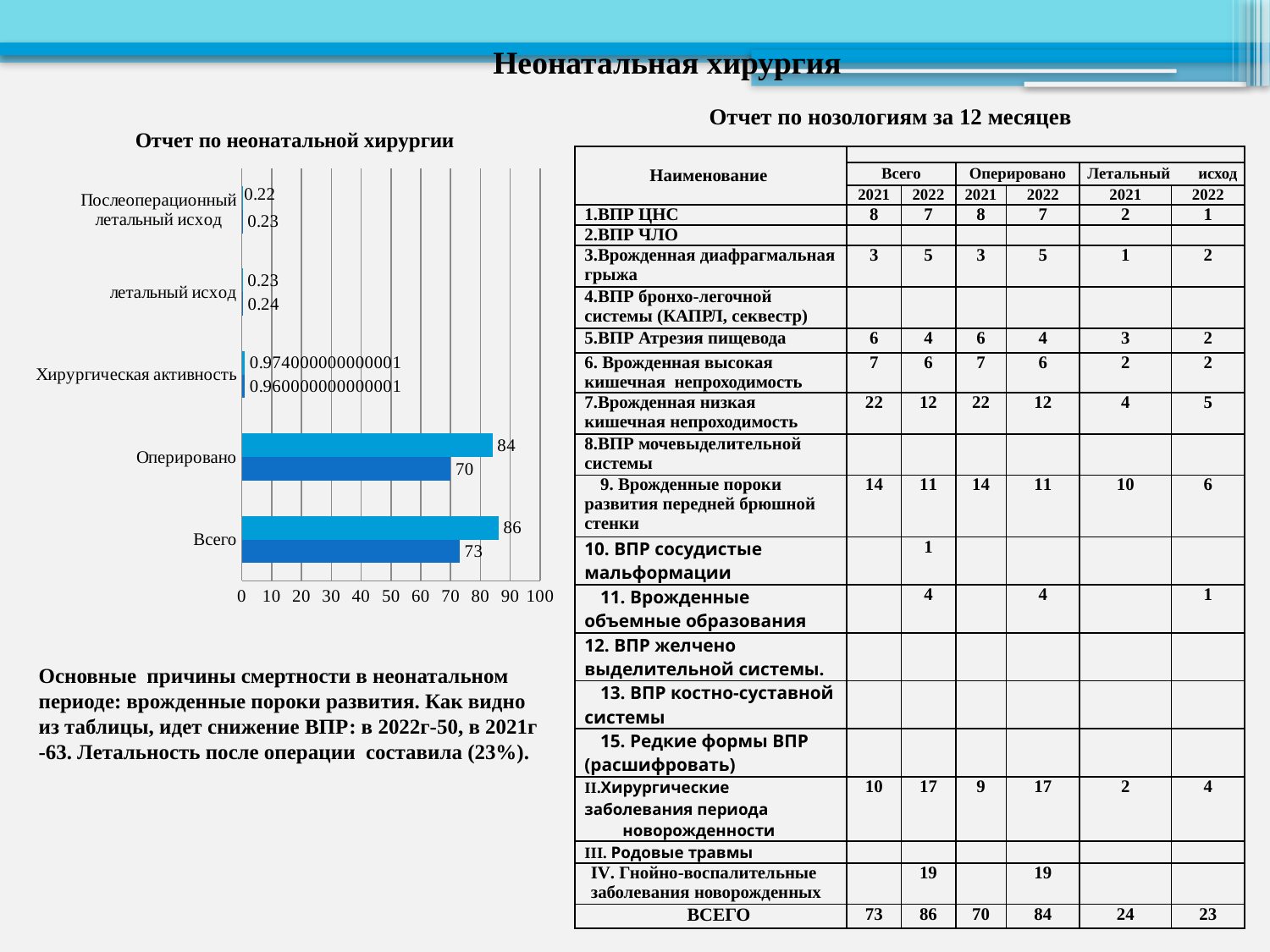
In the chart "Отчет по неонатальной хирургии", what is the value of the light blue (upper) bar for "Оперировано"? 84 In the chart "Отчет по неонатальной хирургии", what is the difference between the light blue and dark blue bars for "Всего"? 13 In the chart "Отчет по неонатальной хирургии", what is the difference between the light blue and dark blue bars for "Оперировано"? 14 In the chart "Отчет по неонатальной хирургии", what is the value of the light blue (upper) bar for "Послеоперационный летальный исход"? 0.22 In the chart "Отчет по неонатальной хирургии", what is the value of the dark blue (lower) bar for "Оперировано"? 70 What kind of chart is shown under the title "Отчет по неонатальной хирургии"? bar chart In the chart "Отчет по неонатальной хирургии", what is the value of the light blue (upper) bar for "Всего"? 86 In the chart "Отчет по неонатальной хирургии", which category has the longest bar? Всего How many categories are shown on the y axis of the chart "Отчет по неонатальной хирургии"? 5 In the chart "Отчет по неонатальной хирургии", what is the value of the dark blue (lower) bar for "Всего"? 73 In the chart "Отчет по неонатальной хирургии", which is larger: the dark blue bar for "Всего" or the dark blue bar for "Оперировано"? Всего In the chart "Отчет по неонатальной хирургии", is the dark blue bar for "Оперировано" greater or less than 60? greater